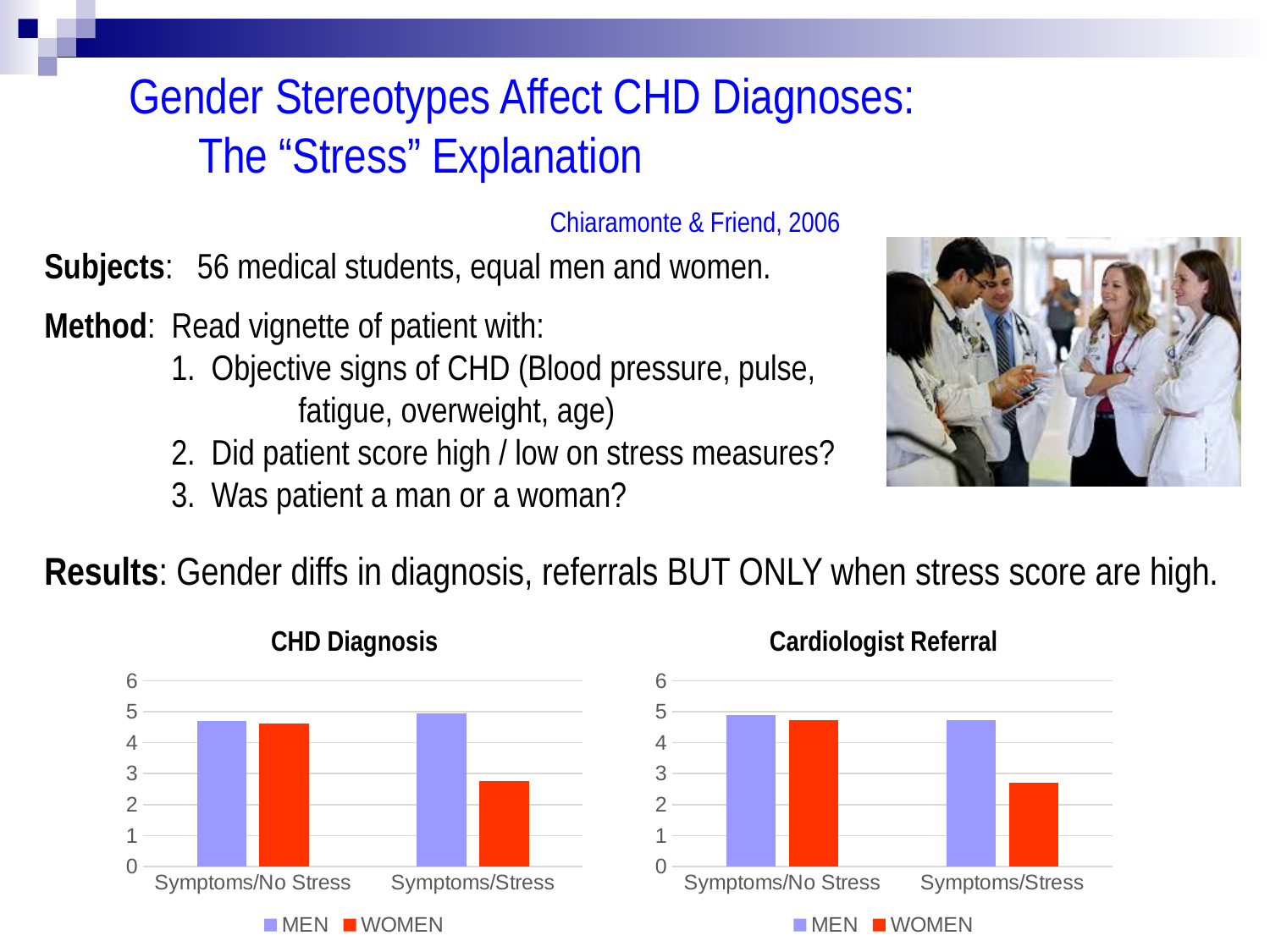
In the CHD Diagnosis chart, is the value for MEN in the Symptoms/Stress category greater or less than 4? greater What are the two series named in the legend of the CHD Diagnosis chart? MEN and WOMEN What colour are the WOMEN bars in the Cardiologist Referral chart? red In the Cardiologist Referral chart, is the value for MEN in the Symptoms/No Stress category greater or less than 4? greater How many categories are shown on the x axis of the CHD Diagnosis chart? 2 In the CHD Diagnosis chart, is the value for WOMEN in the Symptoms/Stress category greater or less than 3? less In the Cardiologist Referral chart, which is larger in the Symptoms/Stress category: MEN or WOMEN? MEN How many series does the legend of the Cardiologist Referral chart list? 2 In the CHD Diagnosis chart, which is larger in the Symptoms/Stress category: MEN or WOMEN? MEN In the Cardiologist Referral chart, which bar is the lowest? WOMEN, Symptoms/Stress What kind of chart is the CHD Diagnosis chart? bar chart